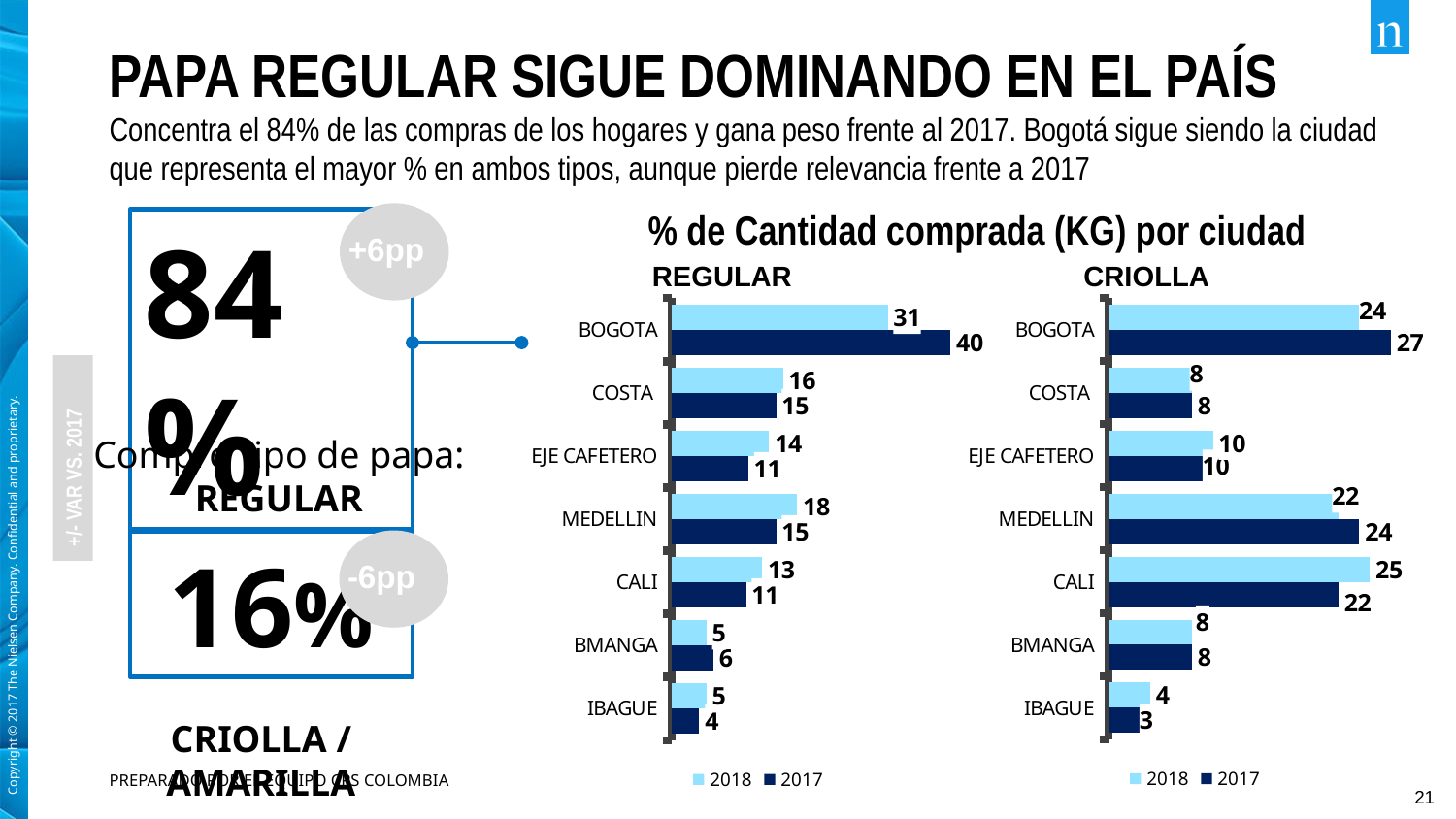
In the REGULAR chart, what is the difference between the 2017 and 2018 values for BOGOTA? 9 In the REGULAR chart, which is larger for COSTA: the 2018 value or the 2017 value? 2018 What type of chart is the CRIOLLA chart? Bar chart In the CRIOLLA chart, what is the 2018 value for CALI? 25 In the REGULAR chart, what is the 2018 value for BOGOTA? 31 How many cities are shown in the CRIOLLA chart? 7 In the REGULAR chart, which city has the highest 2017 value? BOGOTA In the CRIOLLA chart, what is the 2017 value for BOGOTA? 27 In the CRIOLLA chart, which city has the lowest 2017 value? IBAGUE In the REGULAR chart, what is the 2017 value for MEDELLIN? 15 How many series does the legend of the REGULAR chart list? 2 In the CRIOLLA chart, what is the difference between the 2018 and 2017 values for CALI? 3